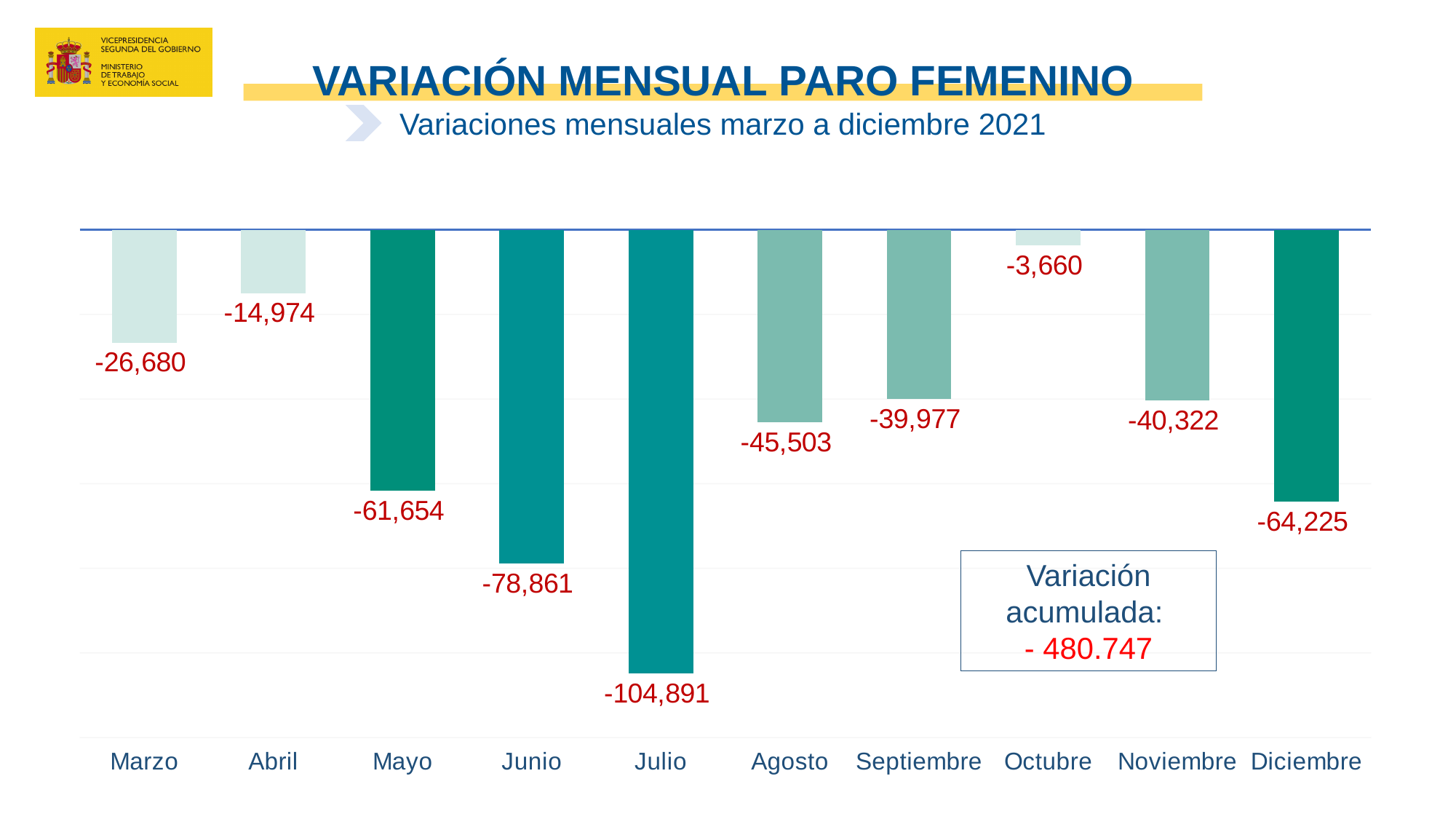
What kind of chart is shown on the slide? Bar chart What is the difference between the values for Agosto and Septiembre? 5,526 Which month has the largest decrease (the lowest value)? Julio How many months are shown on the x axis? 10 What is the difference between the values for Junio and Mayo? 17,207 Which month shows the larger decrease, Junio or Agosto? Junio What is the value for Octubre? -3,660 What is the value for Noviembre? -40,322 Which month has the smallest decrease (the value closest to zero)? Octubre What is the value for Julio? -104,891 What accumulated variation (Variación acumulada) is shown in the box on the chart? - 480.747 What is the value for Marzo? -26,680